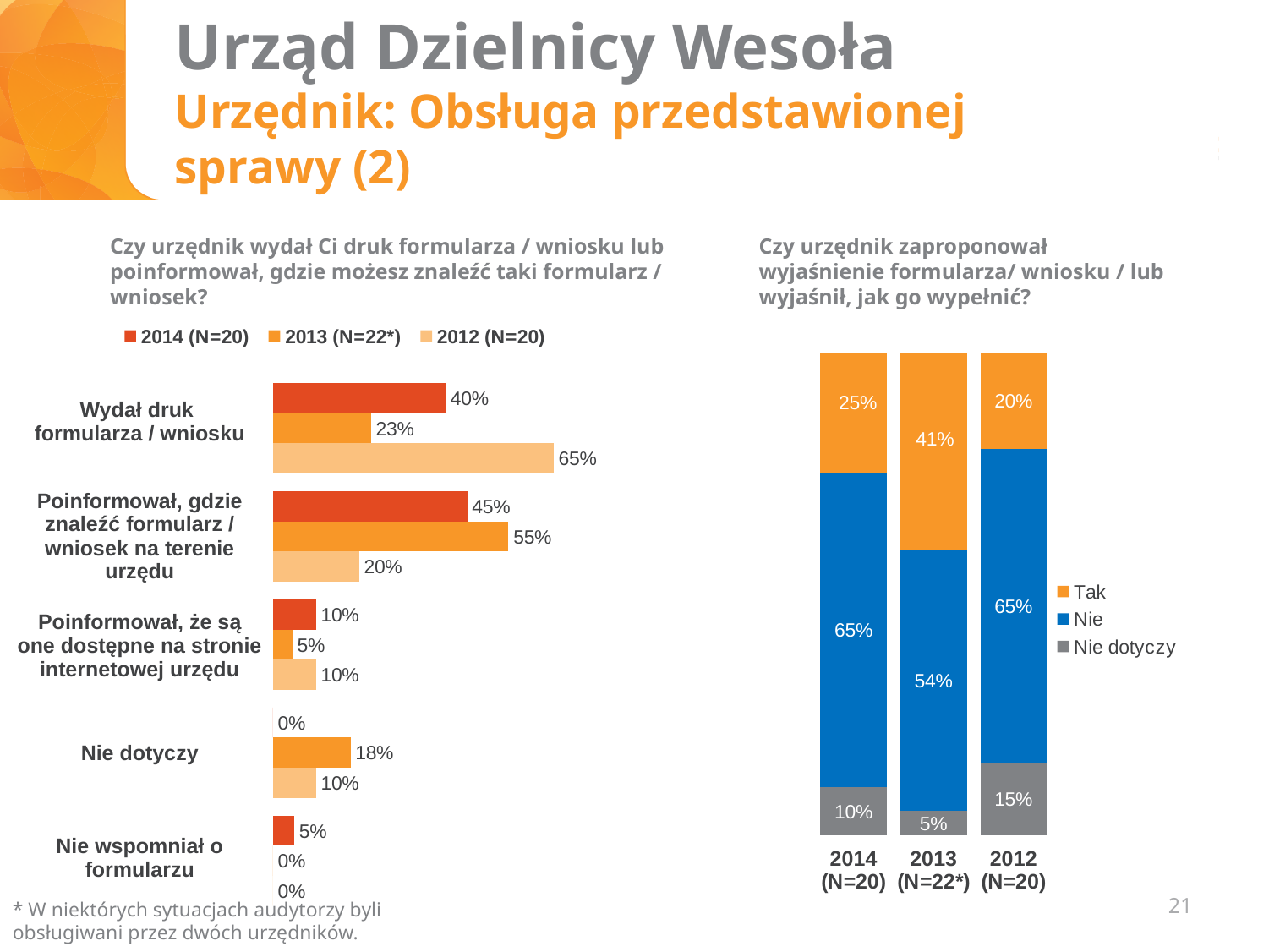
In the left chart, what is the 2013 (N=22*) value for 'Poinformował, gdzie znaleźć formularz / wniosek na terenie urzędu'? 55% How many series does the legend of the left chart list? 3 In the left chart, what is the 2012 (N=20) value for 'Wydał druk formularza / wniosku'? 65% In the left chart, which is larger for 'Nie dotyczy': the 2013 value or the 2012 value? 2013 (N=22*) In the left chart, which year has the highest value for 'Wydał druk formularza / wniosku'? 2012 (N=20) What type of chart is the right chart? Stacked bar chart In the right chart, what is the 'Nie dotyczy' value for 2012 (N=20)? 15% How many categories are shown in the left chart? 5 In the right chart, what is the 'Nie' value for 2013 (N=22*)? 54% In the left chart, what is the difference between the 2014 and 2013 values for 'Wydał druk formularza / wniosku'? 17 percentage points In the right chart, which year has the highest 'Tak' value? 2013 (N=22*) In the right chart, what is the total of the stacked bar for 2014 (N=20)? 100%